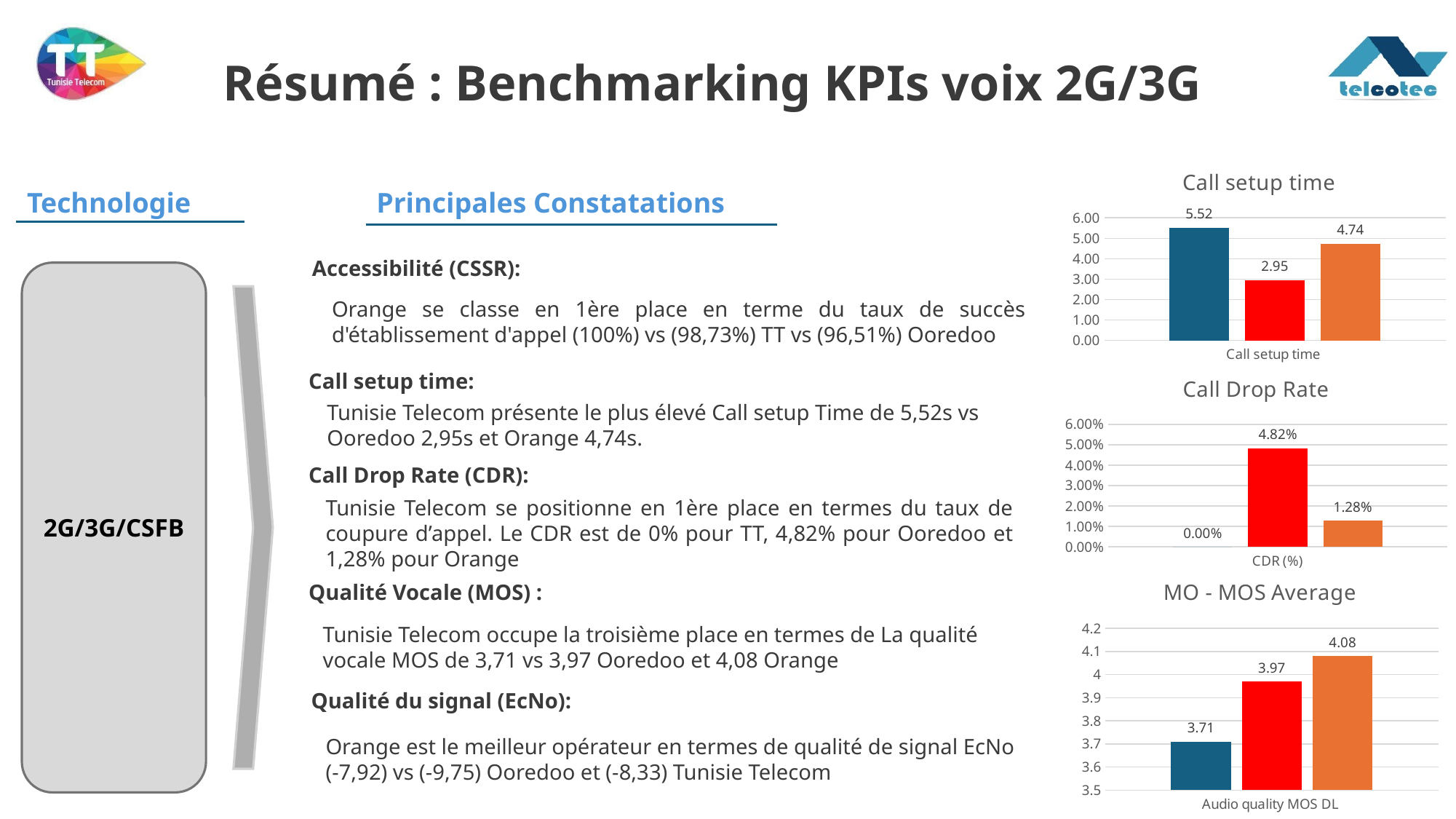
In the Call setup time chart, what is the difference between the highest and lowest values? 2.57 In the MO - MOS Average chart, is the value of the blue bar greater or less than 3.8? less In the Call Drop Rate chart, what is the lowest value shown? 0.00% In the Call setup time chart, what is the highest value shown? 5.52 What kind of chart is the Call Drop Rate chart? bar chart In the MO - MOS Average chart, what is the lowest value shown? 3.71 In the Call setup time chart, how many bars are plotted? 3 In the Call Drop Rate chart, what is the value of the red bar? 4.82% In the MO - MOS Average chart, what is the value of the orange bar? 4.08 In the Call Drop Rate chart, what is the difference between the red bar and the orange bar? 3.54% How many charts are shown on the slide? 3 In the Call setup time chart, what is the lowest value shown? 2.95